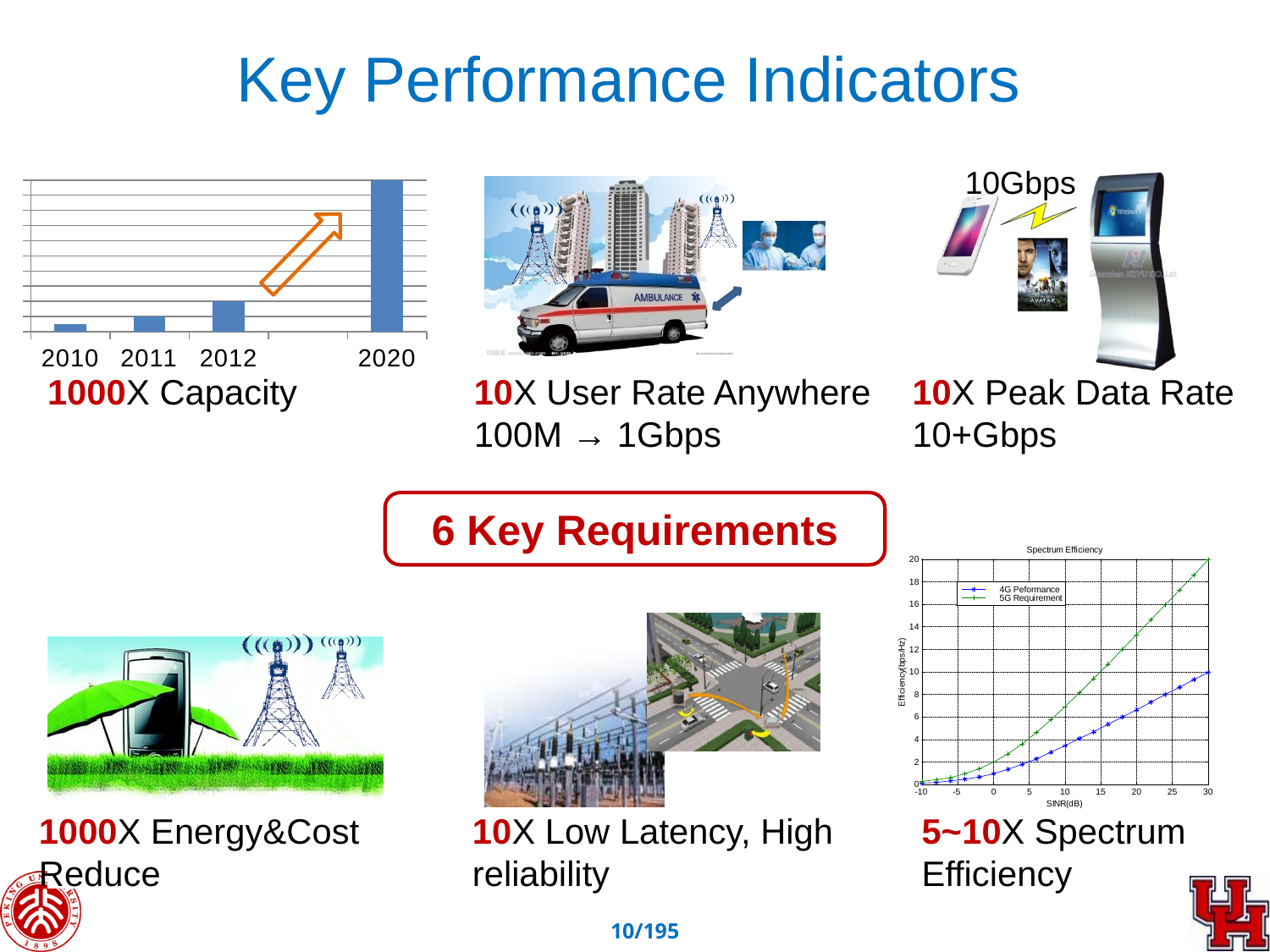
How many years are shown on the x axis of the bar chart at the top left? 4 What kind of chart is the Spectrum Efficiency chart? line chart In the bar chart at the top left, which bar is taller, 2011 or 2012? 2012 In the bar chart at the top left, which year has the shortest bar? 2010 In the Spectrum Efficiency chart, does the 5G Requirement curve rise or fall as SINR increases? rise In the Spectrum Efficiency chart, which series is higher at an SINR of 30 dB, 4G Performance or 5G Requirement? 5G Requirement In the bar chart at the top left, do the bars rise or fall from 2010 to 2020? rise In the bar chart at the top left, which year has the tallest bar? 2020 In the Spectrum Efficiency chart, is the 4G Performance value at an SINR of 30 dB greater or less than 12? less How many series does the legend of the Spectrum Efficiency chart list? 2 What is the title of the line chart at the bottom right of the slide? Spectrum Efficiency What kind of chart is the chart at the top left of the slide? bar chart